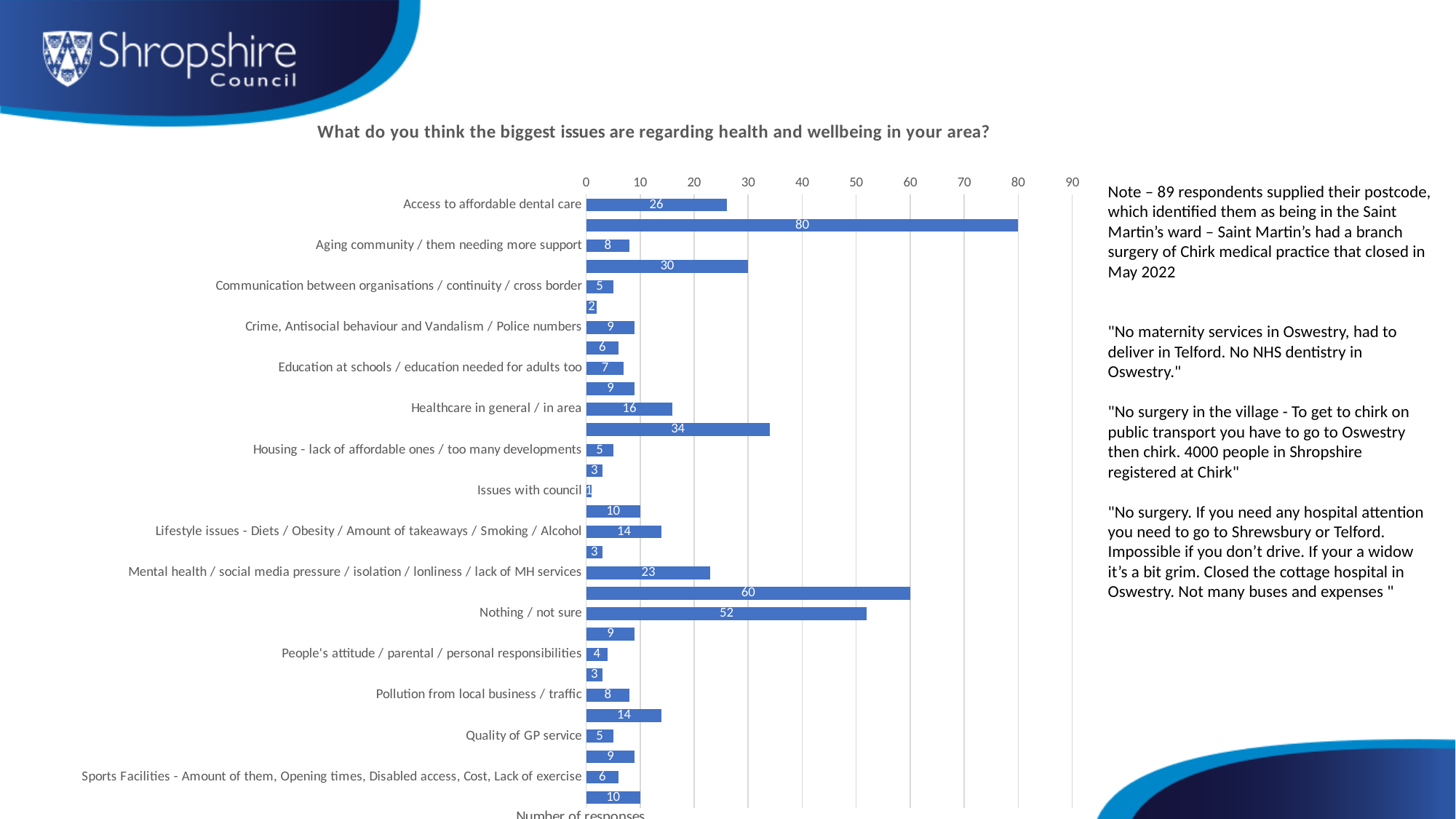
What is the value for Healthcare in general / in area? 16 What is the label of the horizontal axis? Number of responses What is the value for Nothing / not sure? 52 What is the value for Mental health / social media pressure / isolation / lonliness / lack of MH services? 23 What is the value for Lifestyle issues - Diets / Obesity / Amount of takeaways / Smoking / Alcohol? 14 What is the title of the chart? What do you think the biggest issues are regarding health and wellbeing in your area? Which is larger, the value for Healthcare in general / in area or the value for Aging community / them needing more support? Healthcare in general / in area Which labelled category has the lowest value? Issues with council What type of chart is shown on the slide? Bar chart What is the value for Access to affordable dental care? 26 Is the value for Nothing / not sure greater or less than 50? greater What is the difference between the values for Nothing / not sure and Access to affordable dental care? 26